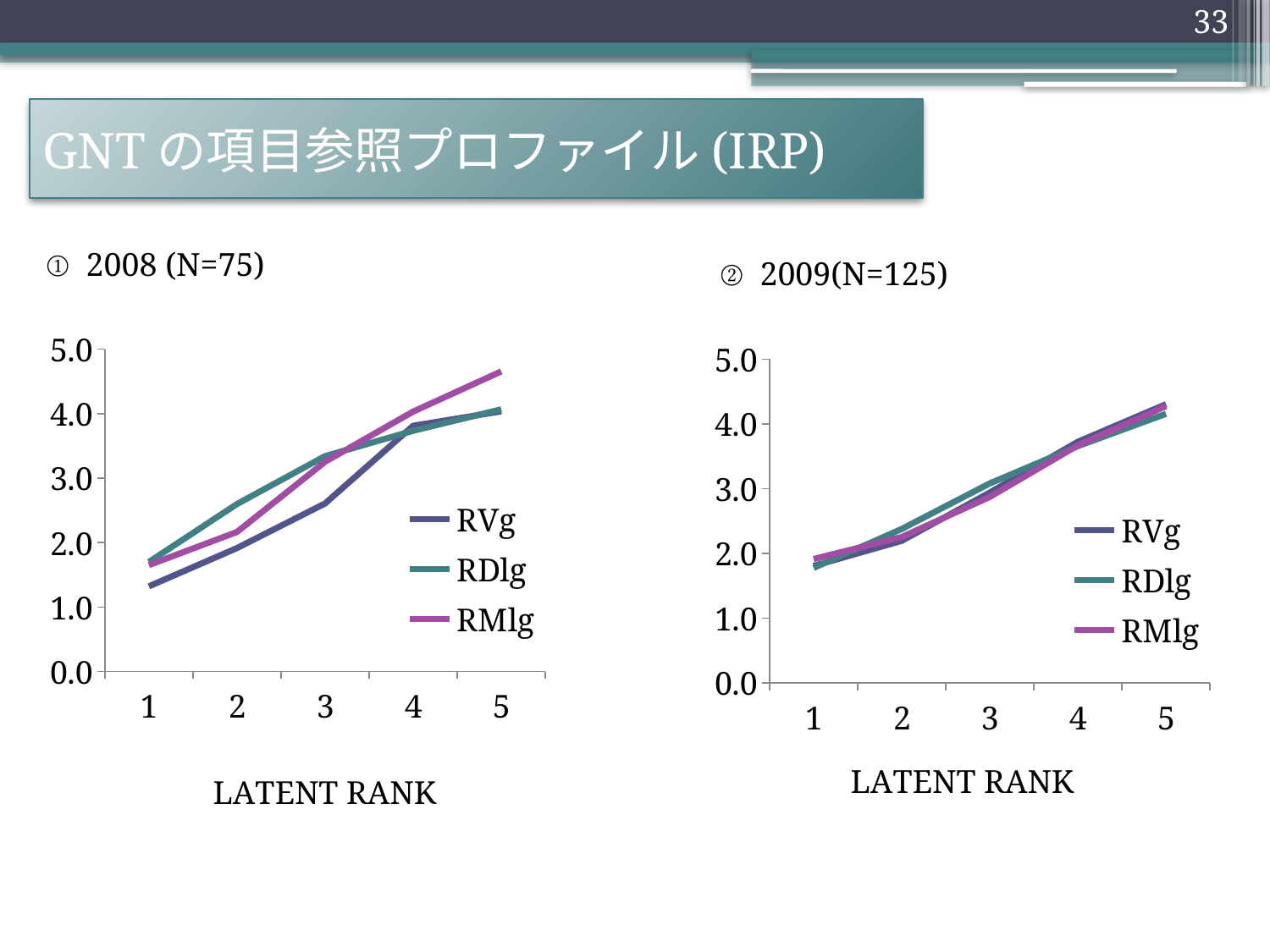
How many series does the legend of the right chart (2009, N=125) list? 3 What kind of chart is the left chart (2008, N=75)? line chart In the left chart (2008, N=75), which series has the lowest value at latent rank 1? RVg In the right chart (2009, N=125), do the RMlg values rise or fall as latent rank increases from 1 to 5? rise In the right chart (2009, N=125), is the value for RDlg at latent rank 5 greater or less than 4.0? greater What is the x-axis title of the right chart (2009, N=125)? LATENT RANK In the left chart (2008, N=75), is the value for RVg at latent rank 1 greater or less than 2.0? less In the left chart (2008, N=75), is the value for RMlg at latent rank 5 greater or less than 4.0? greater In the left chart (2008, N=75), at latent rank 2, which is larger: RDlg or RVg? RDlg How many latent rank categories are shown on the x axis of the left chart (2008, N=75)? 5 In the left chart (2008, N=75), which series has the highest value at latent rank 5? RMlg In the left chart (2008, N=75), do the RVg values rise or fall as latent rank increases from 1 to 5? rise